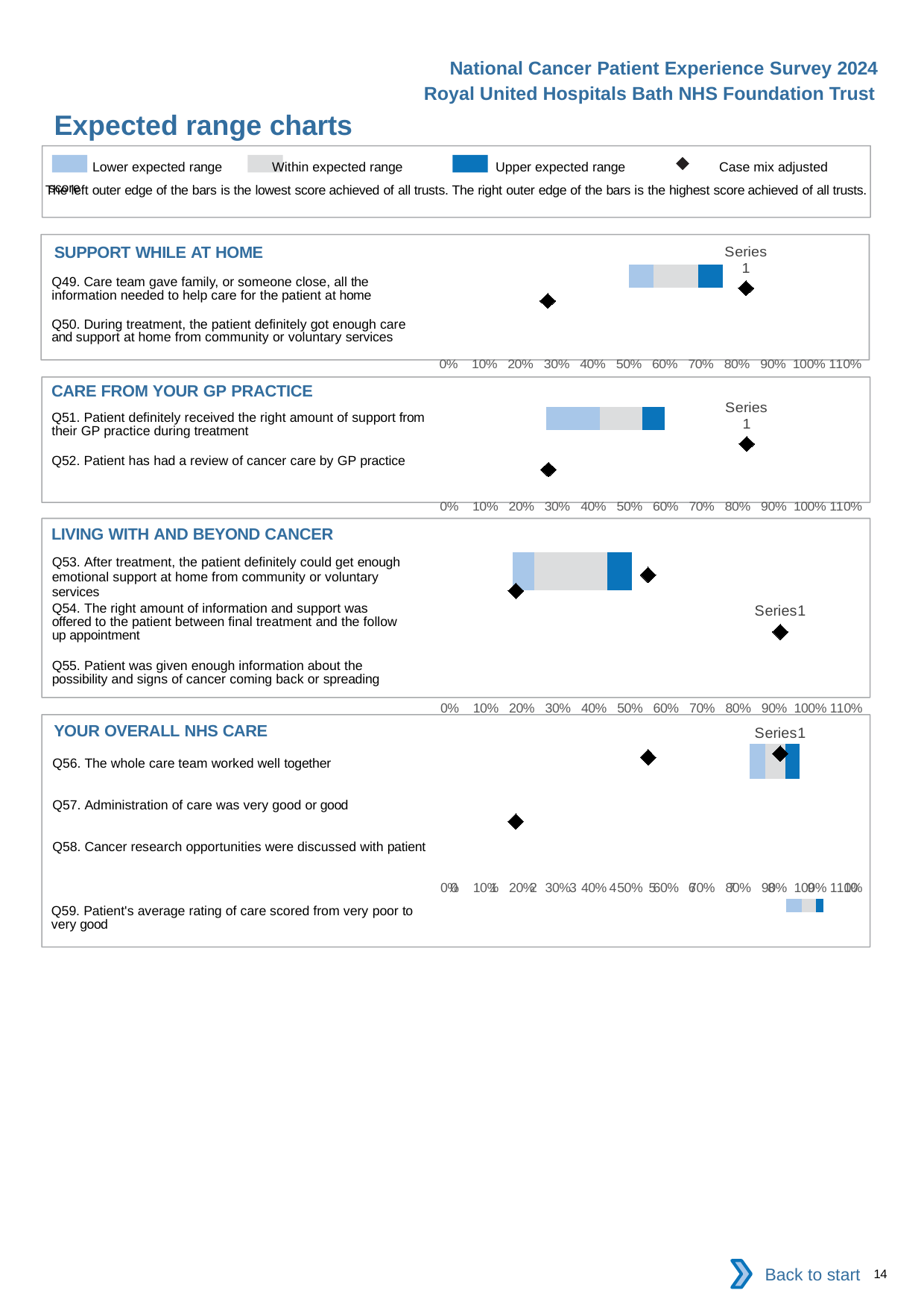
According to the legend, what does the light blue colour in the bars represent? Lower expected range How many questions are listed in the LIVING WITH AND BEYOND CANCER chart? 3 In the CARE FROM YOUR GP PRACTICE chart, is the lower diamond marker greater or less than 50%? less What kind of chart is used in the expected range charts on this slide? bar chart According to the legend, what symbol marks the case mix adjusted score? a diamond In the SUPPORT WHILE AT HOME chart, is the leftmost diamond marker greater or less than 50%? less In the SUPPORT WHILE AT HOME chart, is the rightmost diamond marker greater or less than 70%? greater How many questions are listed in the CARE FROM YOUR GP PRACTICE chart? 2 How many questions are listed in the YOUR OVERALL NHS CARE chart? 4